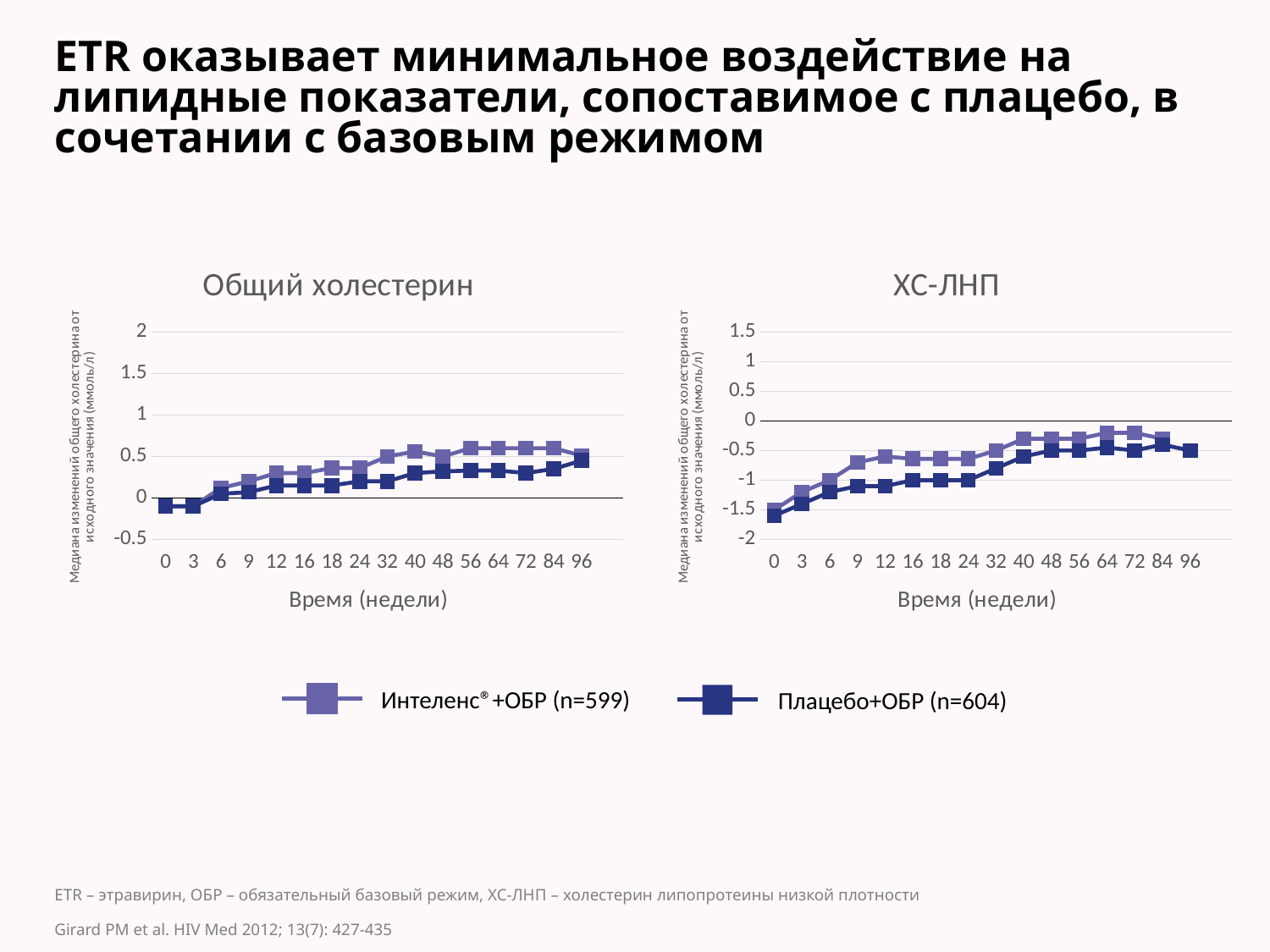
In the "Общий холестерин" chart, is the value for Интеленс+ОБР at week 64 greater or less than 0.5? greater What is the x-axis label of the "ХС-ЛНП" chart? Время (недели) How many series does the legend list? 2 In the "Общий холестерин" chart, how many time points are shown on the x axis? 16 In the "Общий холестерин" chart, is the value for Плацебо+ОБР at week 12 greater or less than 0.5? less In the "Общий холестерин" chart, which series has the larger value at week 40, Интеленс+ОБР or Плацебо+ОБР? Интеленс+ОБР In the "ХС-ЛНП" chart, which series has the larger value at week 24, Интеленс+ОБР or Плацебо+ОБР? Интеленс+ОБР In the "ХС-ЛНП" chart, do the values for Плацебо+ОБР rise or fall from week 0 to week 96? rise In the "ХС-ЛНП" chart, is the value for Интеленс+ОБР at week 64 greater or less than -0.5? greater What kind of chart is the "Общий холестерин" chart? line chart In the "Общий холестерин" chart, do the values for Интеленс+ОБР rise or fall from week 0 to week 64? rise